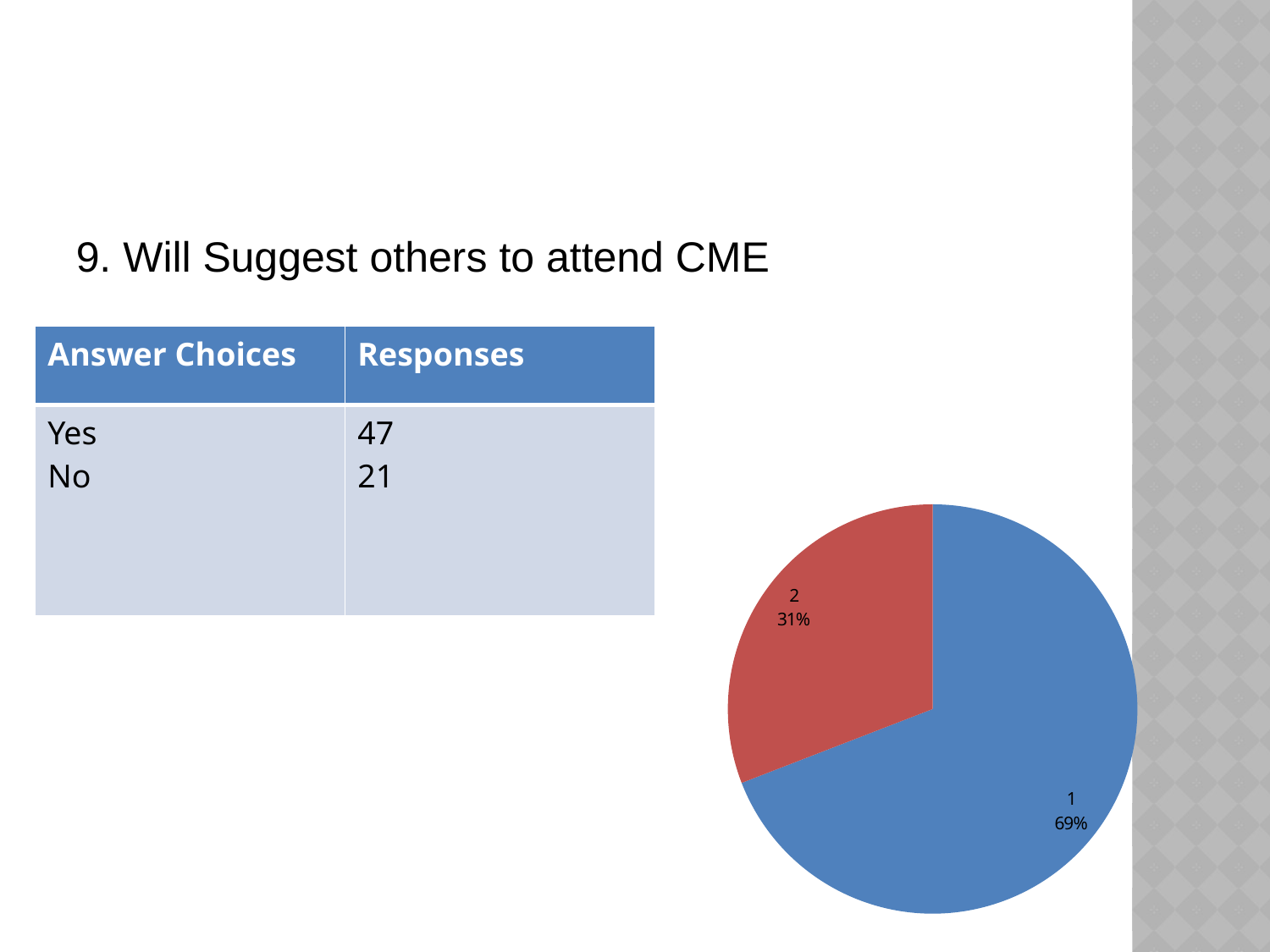
Which slice is larger in the pie chart, 1 or 2? 1 What percentage is shown for slice 1 in the pie chart? 69% How many slices does the pie chart have? 2 What share of the pie does slice 2 represent? 31% Which slice of the pie chart is the smallest? 2 What percentage is shown for slice 2 in the pie chart? 31% What colour is slice 1 in the pie chart? blue What is the difference in percentage points between slice 1 and slice 2 in the pie chart? 38 Which slice of the pie chart is the largest? 1 What kind of chart is shown on the slide? pie chart What colour is slice 2 in the pie chart? red